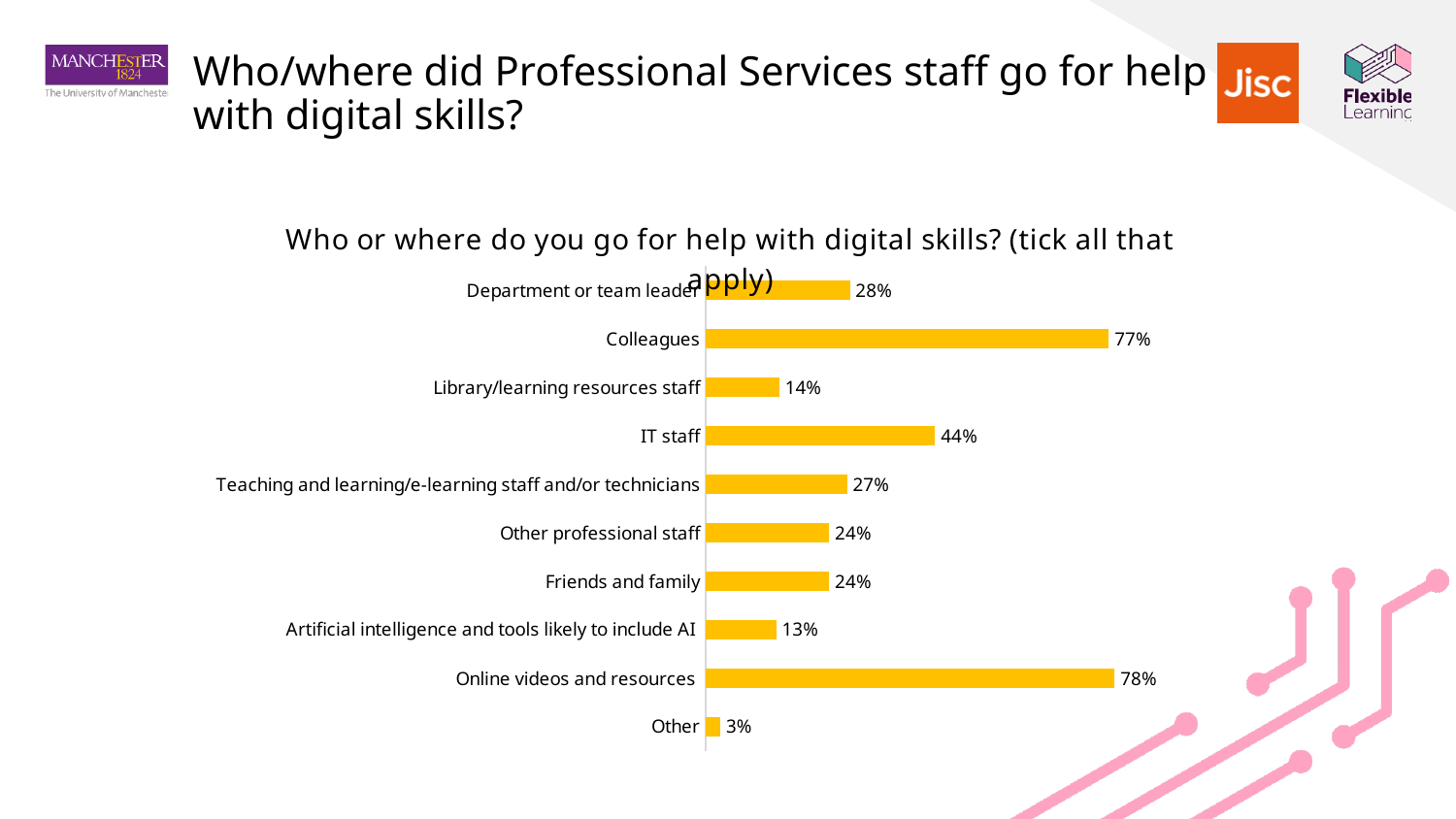
What colour are the bars in the chart? Yellow Which is larger: the value for Library/learning resources staff or the value for Teaching and learning/e-learning staff and/or technicians? Teaching and learning/e-learning staff and/or technicians How many categories are shown in the chart? 10 What is the difference between the values for Online videos and resources and Colleagues? 1% What kind of chart is shown on the slide? Bar chart What percentage is shown for Artificial intelligence and tools likely to include AI? 13% Which category has the lowest value? Other What value is shown for Friends and family? 24% Which category has the highest value? Online videos and resources What is the difference between the values for IT staff and Department or team leader? 16% What is the value for IT staff? 44% What percentage of Professional Services staff go to colleagues for help with digital skills? 77%